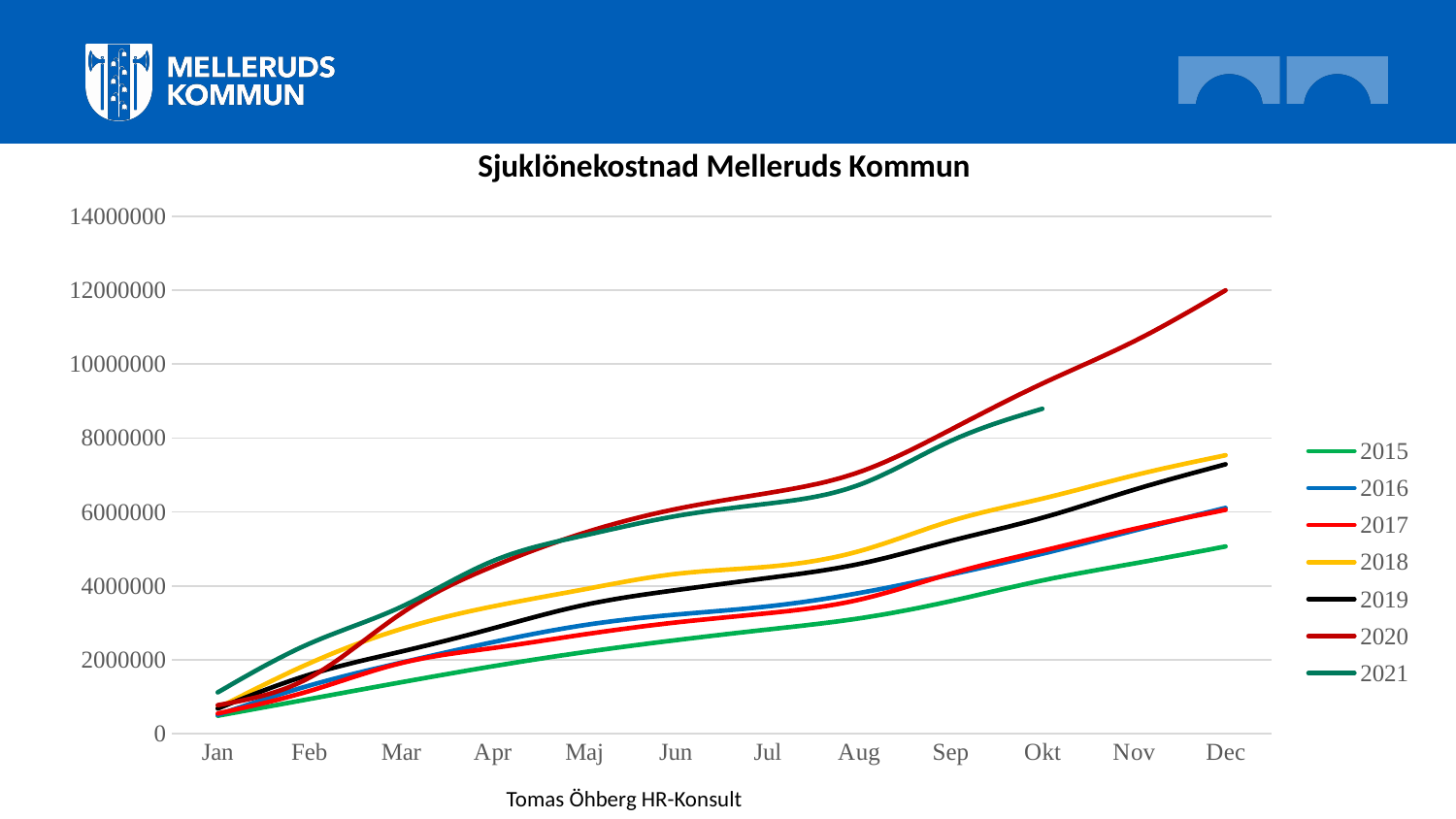
How many months are shown along the x axis? 12 Which series has the lowest value in Dec? 2015 Is the value for 2015 in Dec greater or less than 6000000? less How many series does the legend list? 7 What is the title of the chart? Sjuklönekostnad Melleruds Kommun Which series has the highest value in Dec? 2020 Which series stops at Okt instead of continuing to Dec? 2021 In Dec, which is larger: the value for 2018 or the value for 2019? 2018 What kind of chart is shown on the slide? line chart Is the value for 2021 in Okt greater or less than 8000000? greater Is the value for 2020 in Dec greater or less than 10000000? greater Do the values for 2020 rise or fall from Jan to Dec? rise